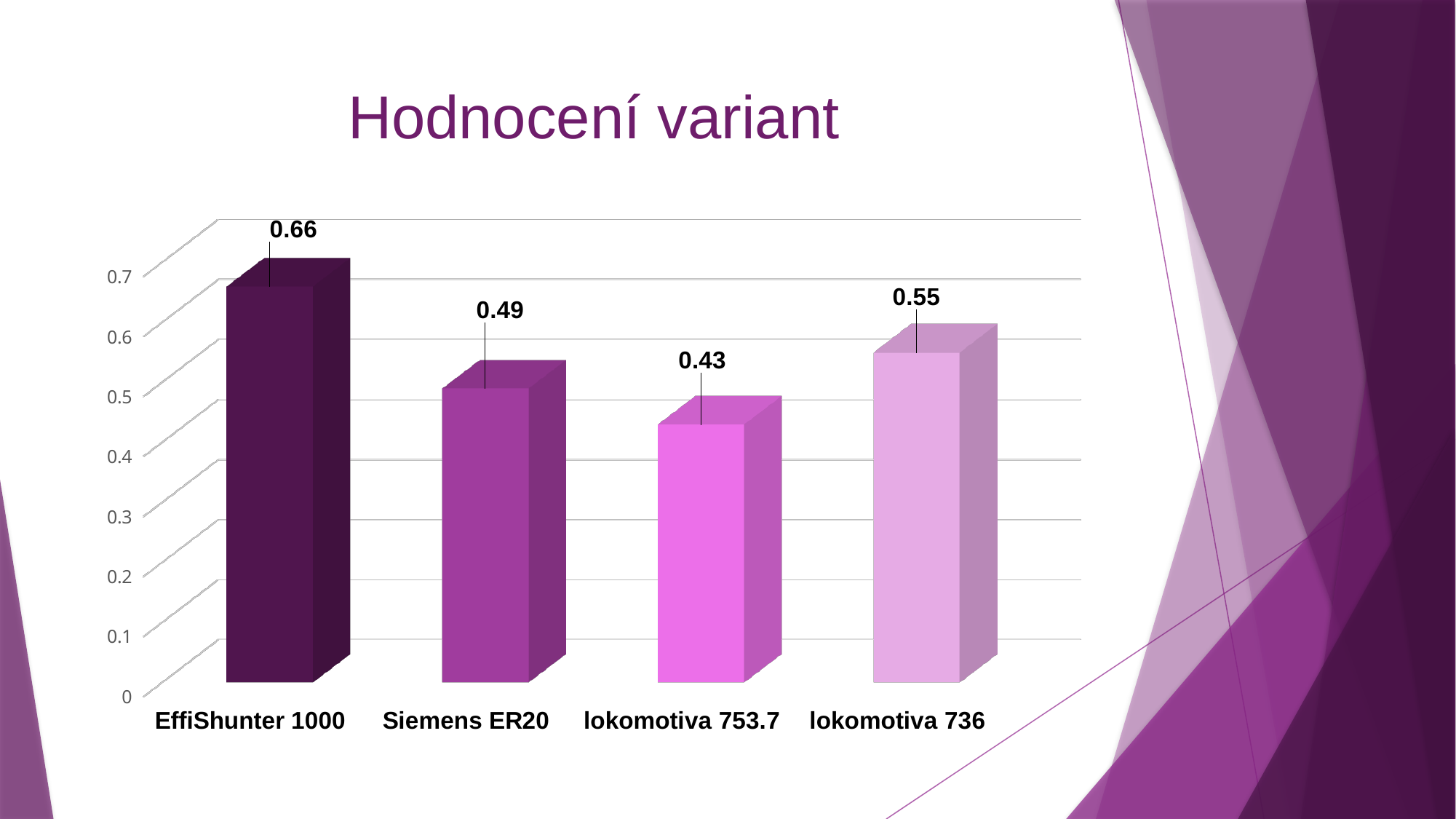
What is the difference between the values for EffiShunter 1000 and lokomotiva 753.7? 0.23 What is the value for EffiShunter 1000? 0.66 What is the value for Siemens ER20? 0.49 How many categories are shown in the chart? 4 What kind of chart is shown on the slide? bar chart What is the value for lokomotiva 753.7? 0.43 Which is larger, the value for Siemens ER20 or the value for lokomotiva 736? lokomotiva 736 What is the value for lokomotiva 736? 0.55 What is the difference between the values for lokomotiva 736 and Siemens ER20? 0.06 Which category has the lowest value? lokomotiva 753.7 What is the title of the slide? Hodnocení variant Which category has the highest value? EffiShunter 1000